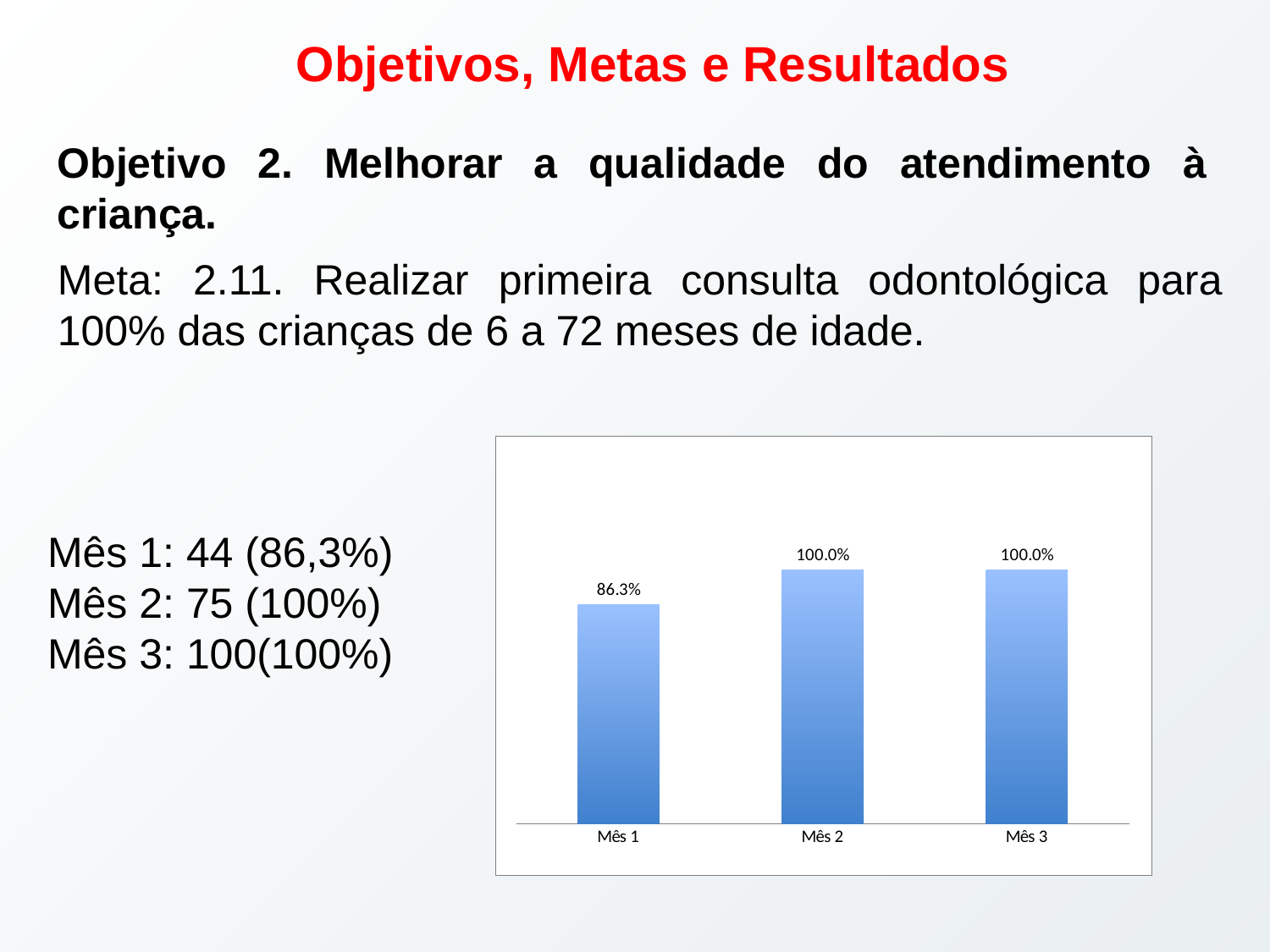
What is the value shown for Mês 1 in the chart? 86.3% Are the values for Mês 2 and Mês 3 equal? Yes How many categories are shown on the x axis of the chart? 3 What colour are the bars in the chart? Blue What kind of chart is shown on the slide? Bar chart Which is larger, the value for Mês 1 or the value for Mês 3? Mês 3 What is the value shown for Mês 2 in the chart? 100.0% Which category has the lowest value in the chart? Mês 1 What is the difference between the values for Mês 2 and Mês 1? 13.7% What is the value shown for Mês 3 in the chart? 100.0% Do the values rise or fall from Mês 1 to Mês 2? Rise What is the label of the first category on the x axis? Mês 1